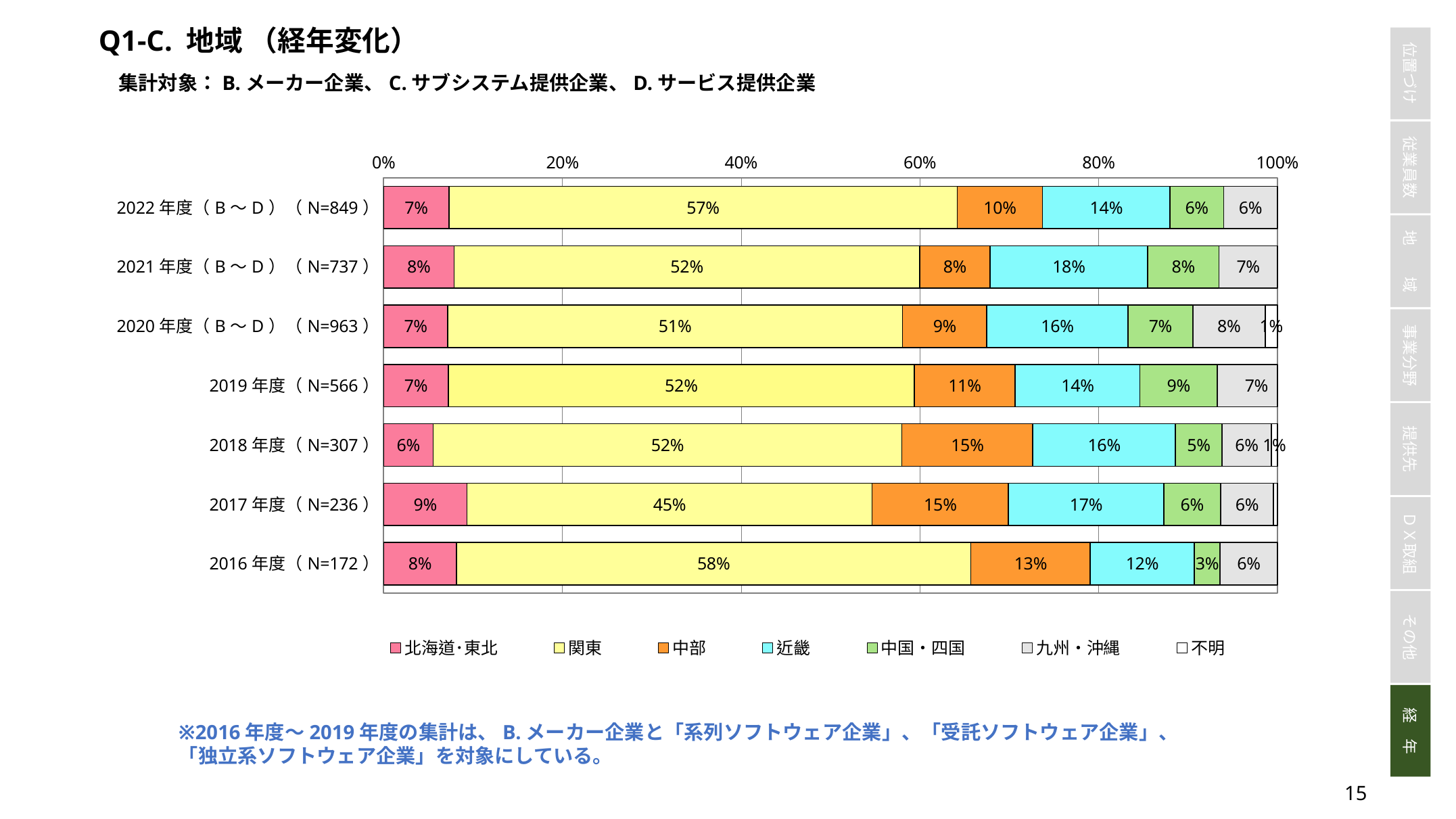
How many series does the legend list? 7 What is the first series listed in the legend? 北海道･東北 In which year is the 関東 share the highest? 2016年度 (N=172) In which year is the 関東 share the lowest? 2017年度 (N=236) How many year categories (bars) are plotted in the chart? 7 What is the value for 中部 in 2018年度 (N=307)? 15% What kind of chart is shown on the slide? stacked bar chart What is the value for 関東 in 2022年度 (N=849)? 57% What is the value for 中国・四国 in 2016年度 (N=172)? 3% Which is larger, the 中部 share in 2019年度 or the 中部 share in 2017年度? 2017年度 What is the value for 近畿 in 2021年度 (N=737)? 18% What is the difference between the 関東 share in 2022年度 and in 2021年度? 5%